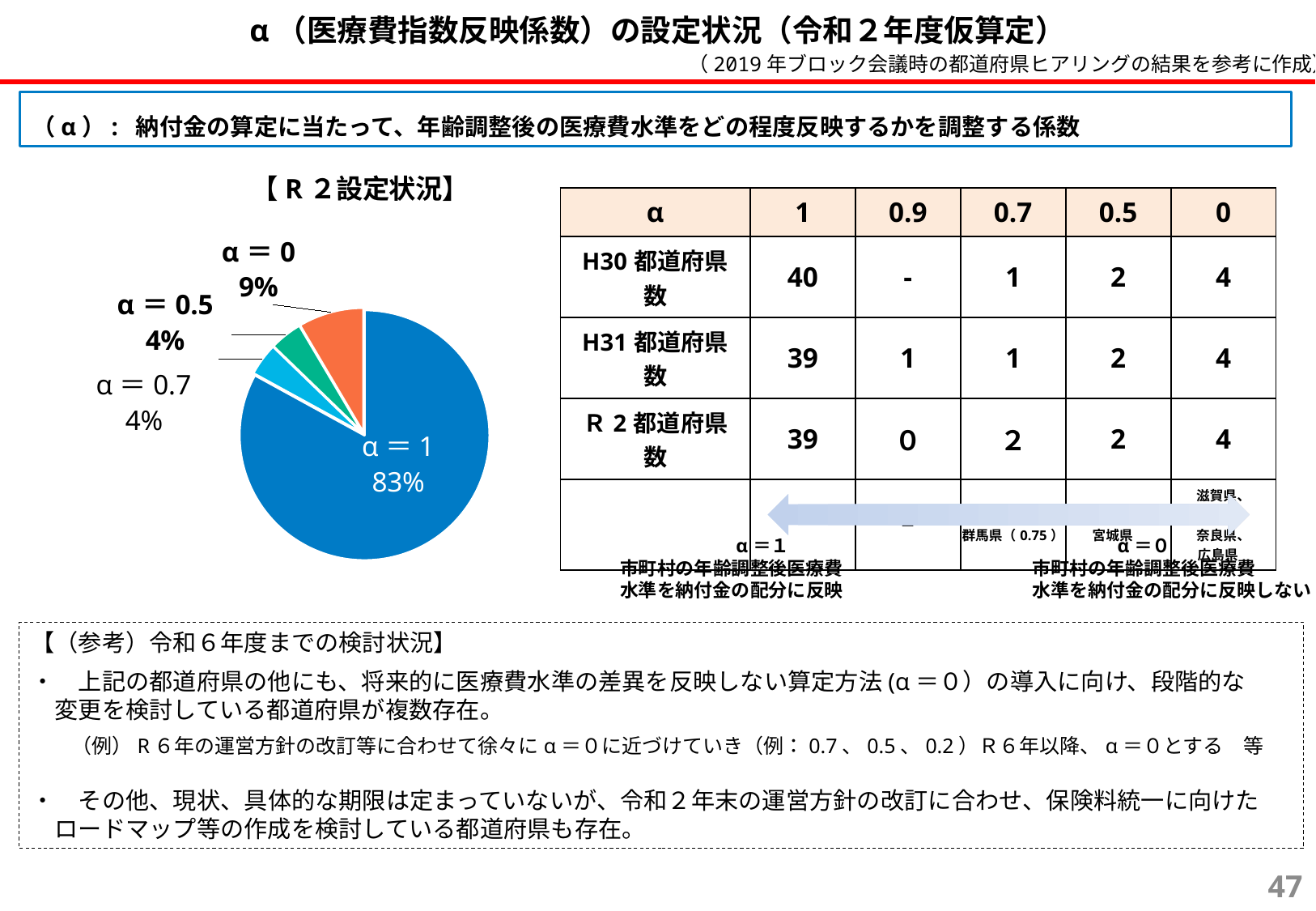
In the pie chart, what share is shown for α＝0.7? 4% In the pie chart, what is the difference between the share for α＝0 and the share for α＝0.7? 5% Which slice of the pie chart is the largest? α＝1 In the pie chart, what share is shown for α＝0.5? 4% What is the title shown above the pie chart? 【R２設定状況】 In the pie chart, what is the difference between the share for α＝1 and the share for α＝0? 74% What kind of chart is shown under the heading 【R２設定状況】? pie chart In the pie chart, what share is shown for α＝0? 9% In the pie chart, what share is shown for α＝1? 83% In the pie chart, which is larger, the share for α＝0 or the share for α＝0.5? α＝0 How many slices does the pie chart have? 4 What colour is the α＝1 slice in the pie chart? blue